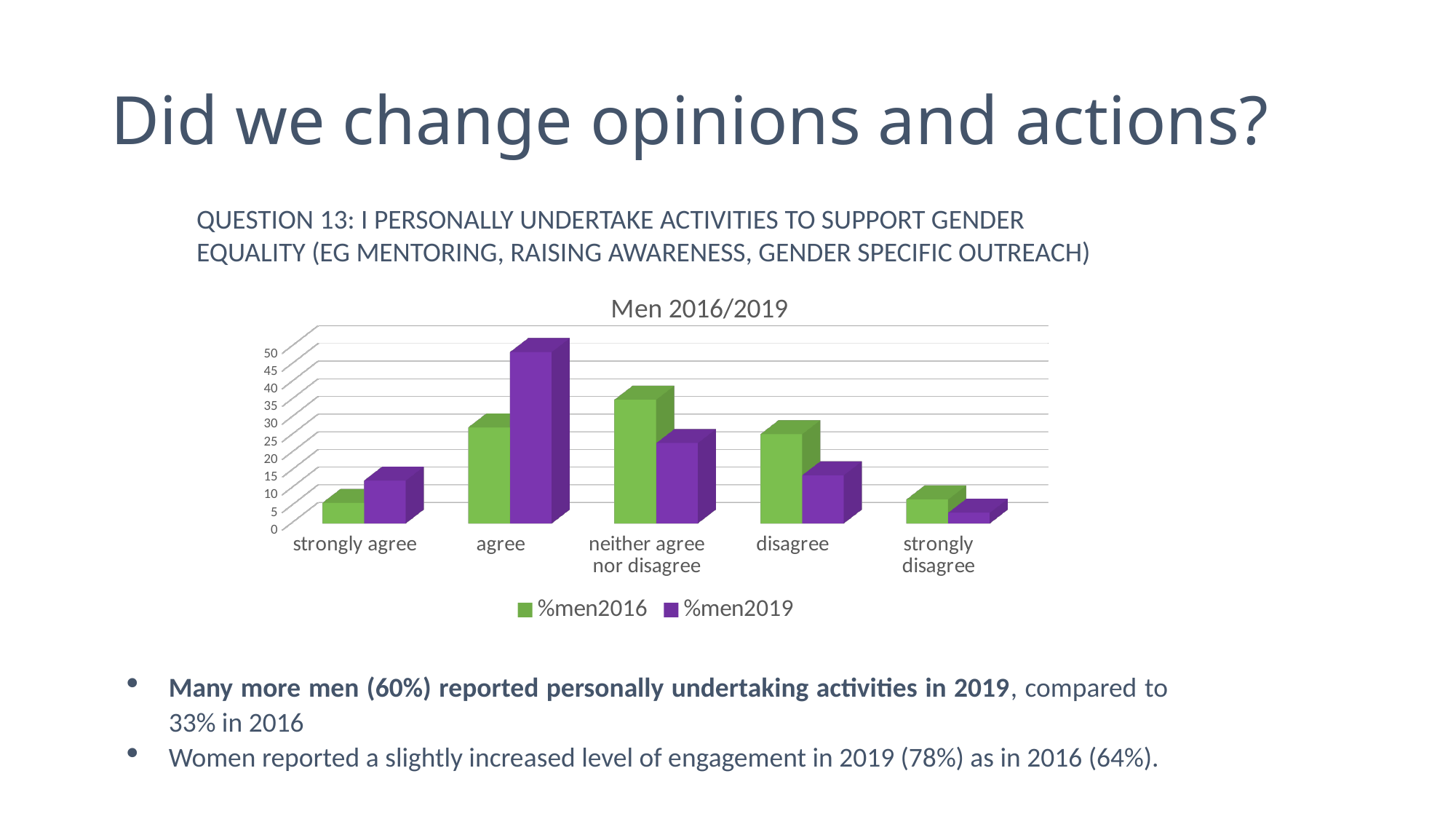
For the %men2019 series, which category has the highest value? agree Is the %men2019 value for 'agree' greater or less than 40? greater What kind of chart is shown on the slide? bar chart For the %men2016 series, which category has the highest value? neither agree nor disagree What is the title of the chart? Men 2016/2019 How many series does the chart legend list? 2 Is the %men2016 value for 'strongly agree' greater or less than 10? less How many response categories are shown on the x axis of the chart? 5 For the 'agree' category, which series is larger, %men2016 or %men2019? %men2019 For the %men2019 series, which category has the lowest value? strongly disagree Which colour represents the %men2019 series in the chart? purple For the 'neither agree nor disagree' category, which series is larger, %men2016 or %men2019? %men2016